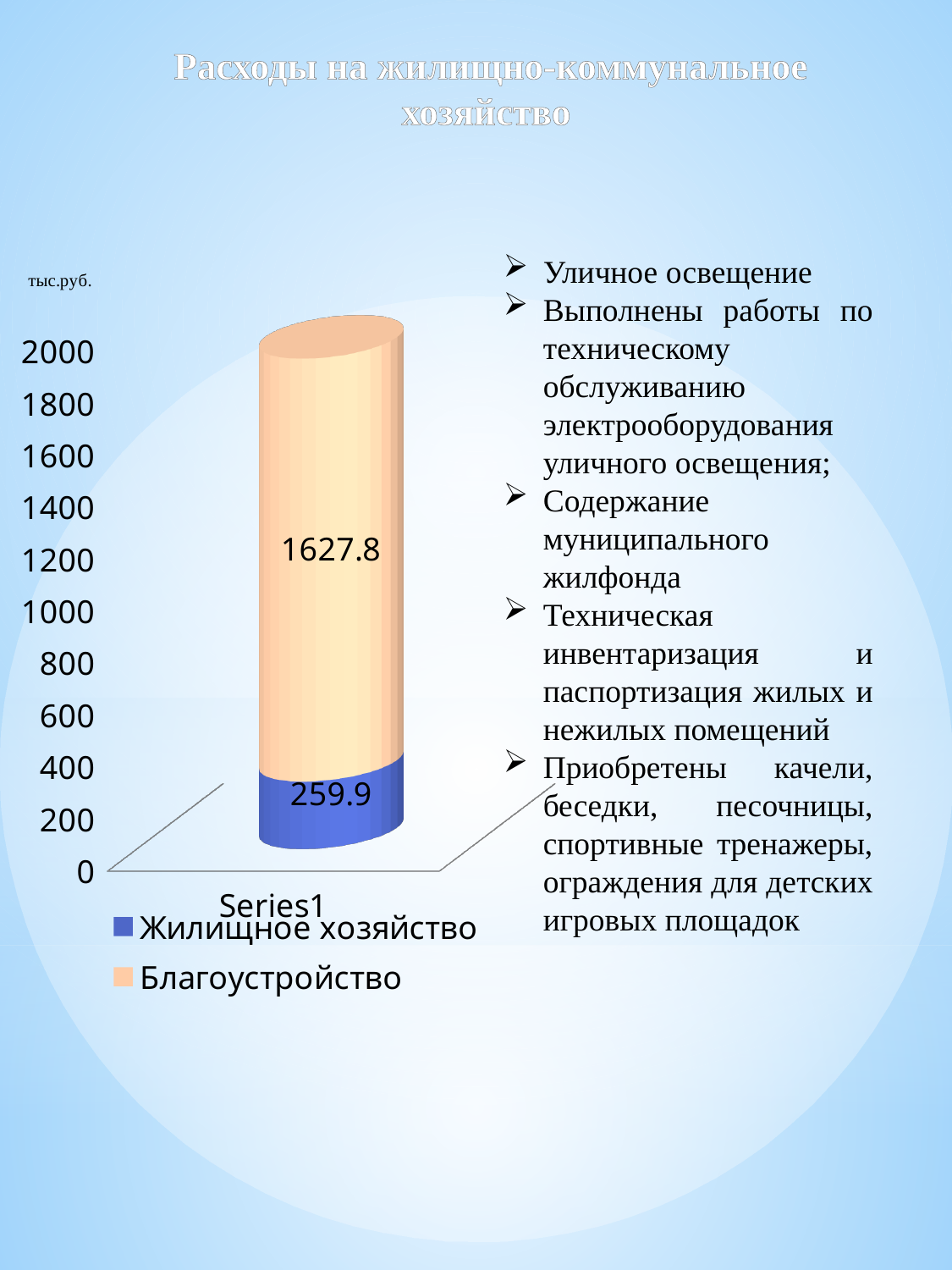
Which series has the largest value in the chart? Благоустройство What is the value for Жилищное хозяйство? 259.9 How many bars are plotted in the chart? 1 Which series has the smallest value in the chart? Жилищное хозяйство What is the value for Благоустройство? 1627.8 What is the difference between the values for Благоустройство and Жилищное хозяйство? 1367.9 Which series has the larger value, Жилищное хозяйство or Благоустройство? Благоустройство What is the title of the slide? Расходы на жилищно-коммунальное хозяйство What kind of chart is shown on the slide? Stacked bar chart What is the total of the stacked bar? 1887.7 What unit is indicated for the values on the chart? тыс.руб. How many series does the legend list? 2